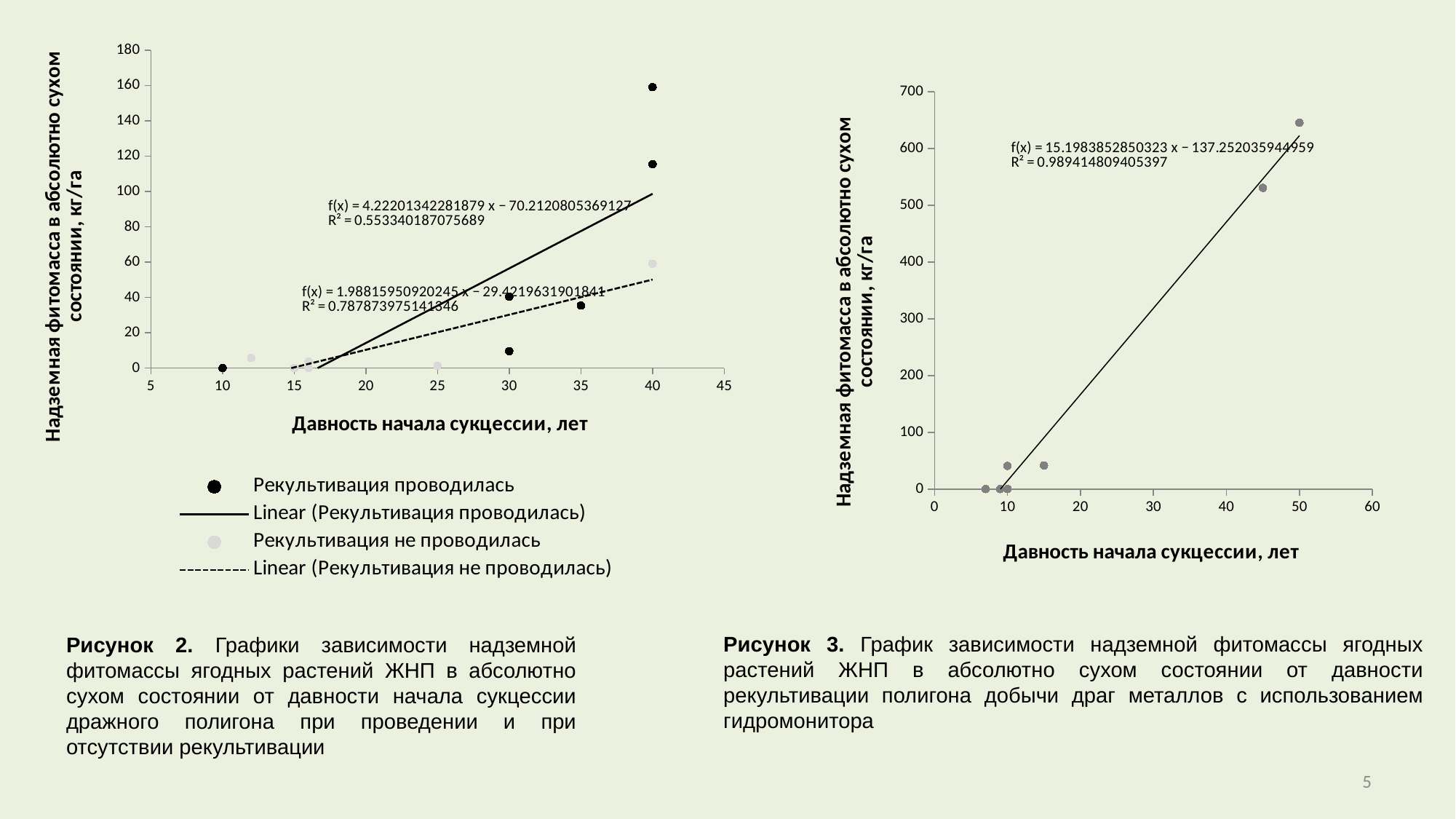
On the left chart (Рисунок 2), is the highest Рекультивация проводилась point at 40 years greater or less than 140? greater On the right chart (Рисунок 3), is the value at 50 years greater or less than 600? greater What kind of chart is Рисунок 2 (the left chart)? scatter chart On the right chart (Рисунок 3), do the values rise or fall as the years since succession increase? rise On the right chart (Рисунок 3), is the value at 45 years greater or less than 500? greater On the left chart (Рисунок 2), does the trendline for Рекультивация проводилась rise or fall along the x axis? rise On the right chart (Рисунок 3), what is the R² value shown for the trendline? 0.989414809405397 On the left chart (Рисунок 2), at 40 years, which series has the higher points: Рекультивация проводилась or Рекультивация не проводилась? Рекультивация проводилась On the left chart (Рисунок 2), what is the R² value shown for the trendline of Рекультивация проводилась? 0.553340187075689 How many entries does the legend of the left chart (Рисунок 2) list? 4